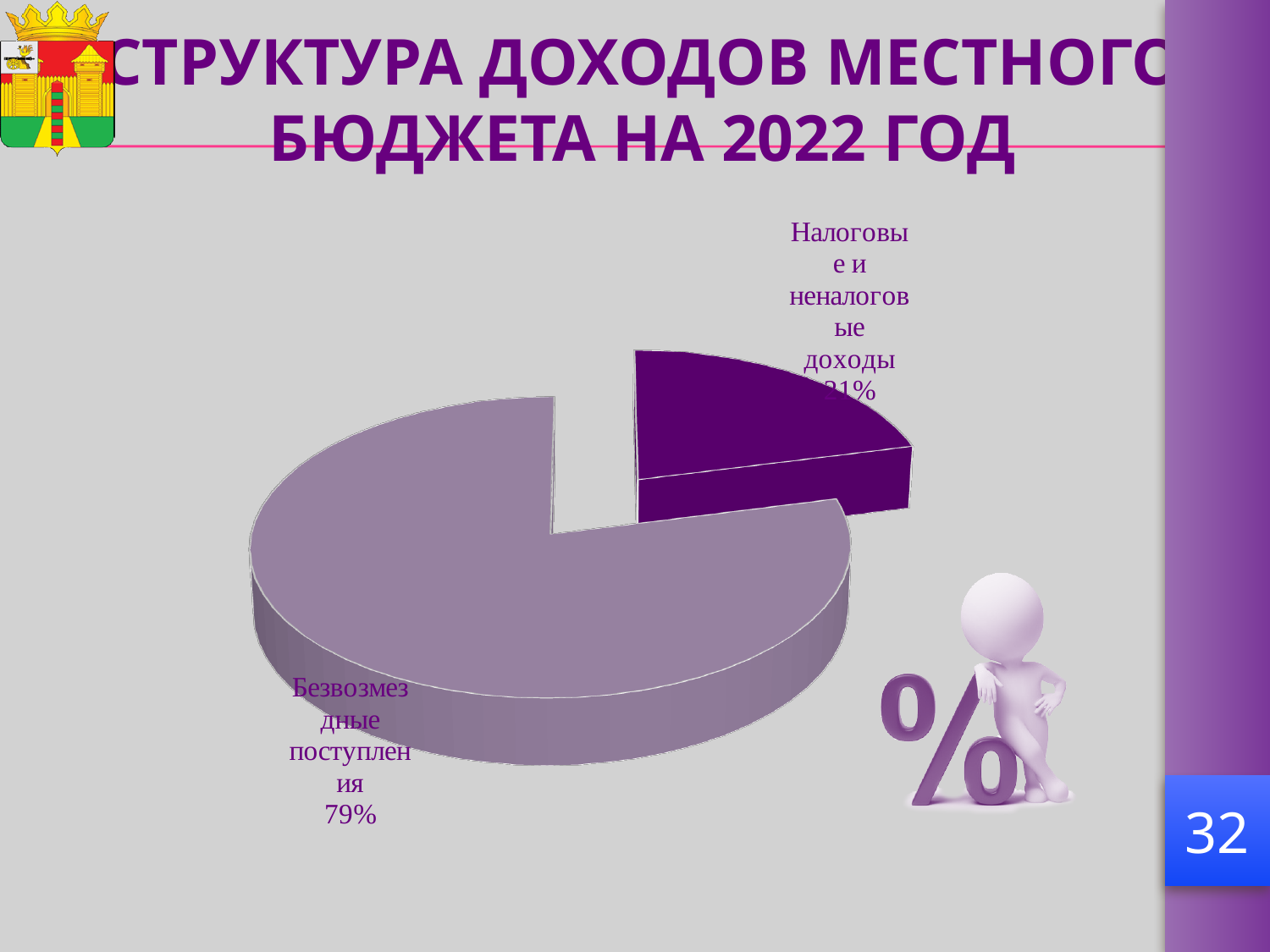
What is the title of the slide containing the chart? СТРУКТУРА ДОХОДОВ МЕСТНОГО БЮДЖЕТА НА 2022 ГОД Which slice is drawn in dark purple? Налоговые и неналоговые доходы How many slices does the pie chart have? 2 Which category has the largest slice of the pie? Безвозмездные поступления Which category has the smallest slice of the pie? Налоговые и неналоговые доходы What kind of chart is shown on the slide? pie chart What is the value shown for "Безвозмездные поступления"? 79% Which is larger: "Безвозмездные поступления" or "Налоговые и неналоговые доходы"? Безвозмездные поступления What share of the pie does "Безвозмездные поступления" account for? 79%